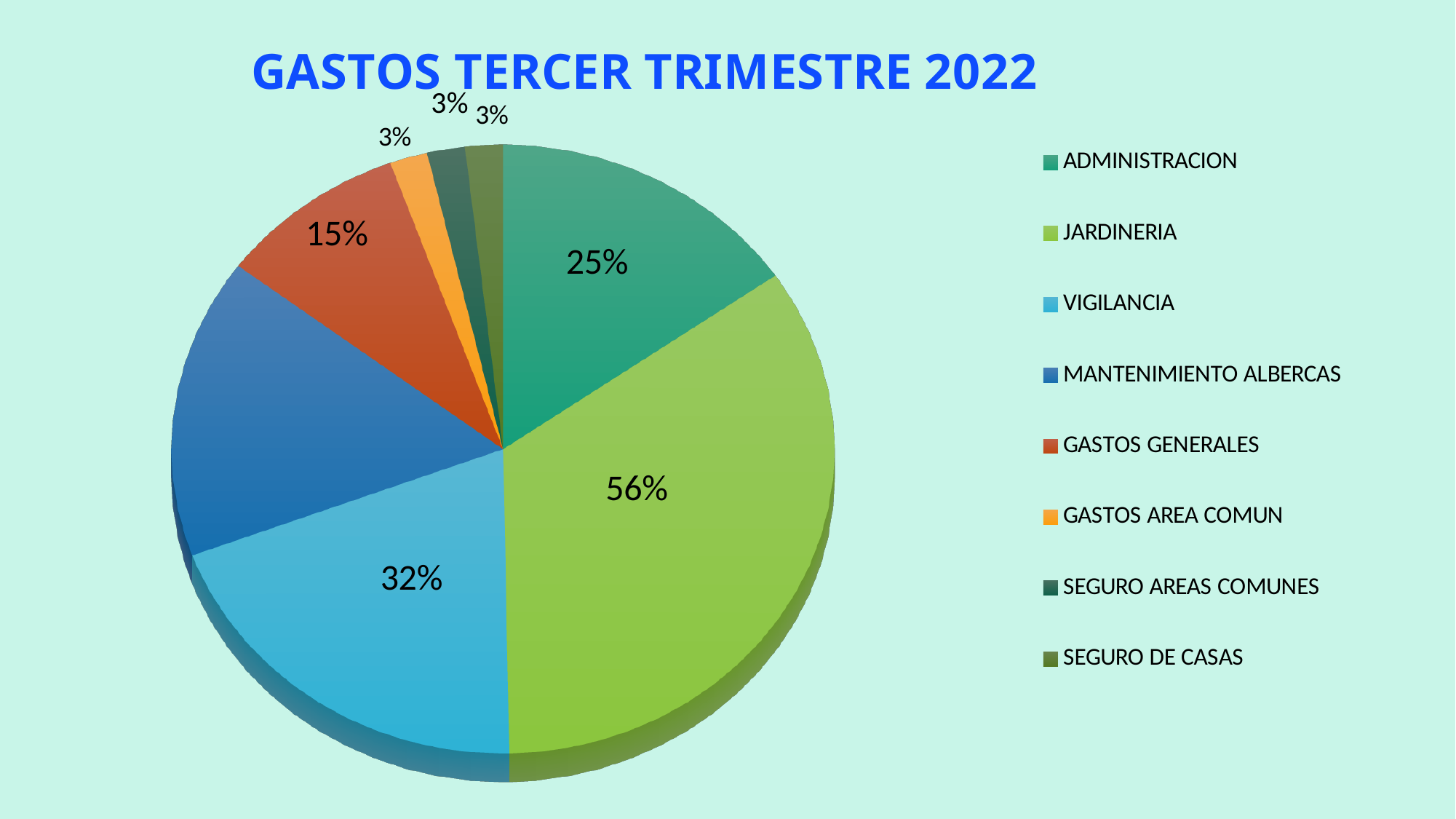
Which category has the largest slice of the pie? JARDINERIA What percentage is shown for VIGILANCIA? 32% What percentage does the JARDINERIA slice show? 56% Which is larger, the VIGILANCIA slice or the ADMINISTRACION slice? VIGILANCIA What percentage is shown for GASTOS GENERALES? 15% What is the title of the chart? GASTOS TERCER TRIMESTRE 2022 What percentage is shown for ADMINISTRACION? 25% How many categories does the legend list? 8 What colour is the JARDINERIA slice? Light green What percentage is shown for GASTOS AREA COMUN? 3% What kind of chart is shown on the slide? Pie chart What is the difference in percentage points between the JARDINERIA and VIGILANCIA slices? 24